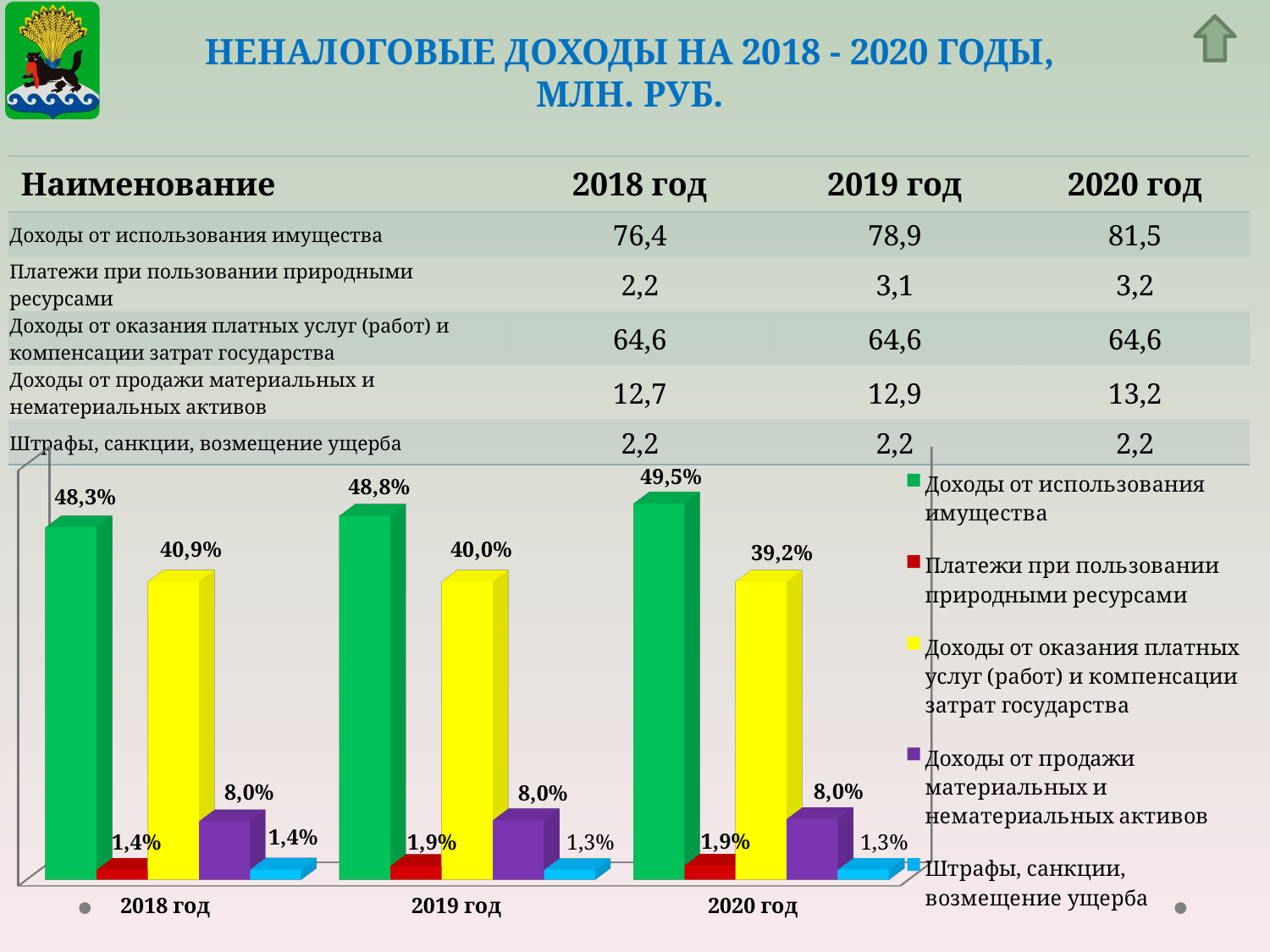
Which is larger on the chart: Доходы от продажи материальных и нематериальных активов in 2019 год or Платежи при пользовании природными ресурсами in 2019 год? Доходы от продажи материальных и нематериальных активов Does the value for Доходы от использования имущества rise or fall from 2018 год to 2020 год on the chart? Rise What is the value for Доходы от использования имущества in 2018 год on the chart? 48,3% What is the value for Штрафы, санкции, возмещение ущерба in 2020 год on the chart? 1,3% In which year is the value for Доходы от использования имущества the highest on the chart? 2020 год How many year categories are shown on the x axis of the chart? 3 What is the value for Платежи при пользовании природными ресурсами in 2019 год on the chart? 1,9% In which year is the value for Доходы от оказания платных услуг (работ) и компенсации затрат государства the lowest on the chart? 2020 год What is the value for Доходы от оказания платных услуг (работ) и компенсации затрат государства in 2020 год on the chart? 39,2% How many series does the chart legend list? 5 What is the difference between the values for Доходы от использования имущества in 2020 год and 2018 год on the chart? 1,2% What kind of chart is shown on the slide? Bar chart